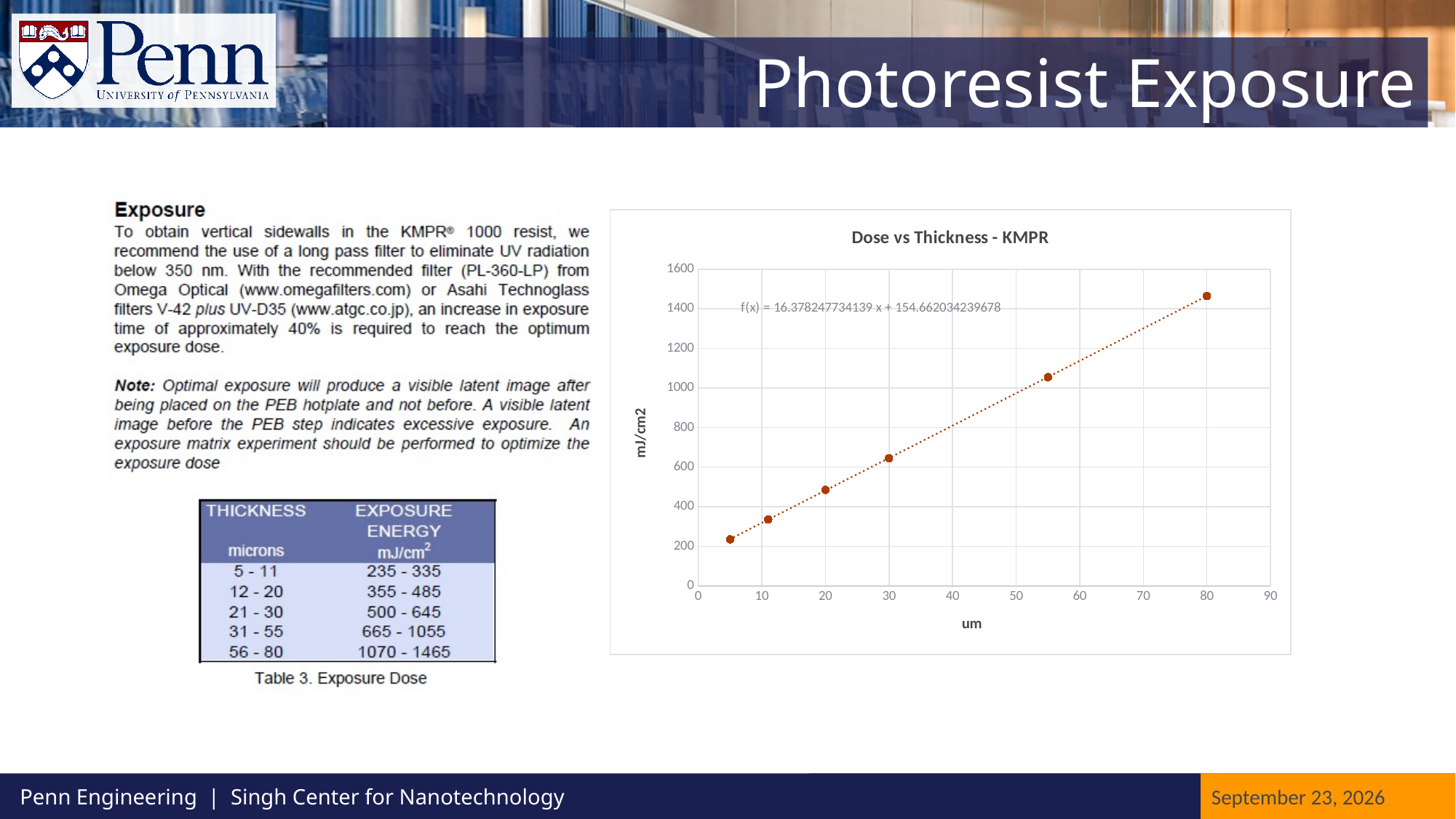
Do the plotted values rise or fall as thickness (um) increases? rise What kind of chart is shown on the slide? scatter chart What is the title of the chart? Dose vs Thickness - KMPR Is the value for the point at 30 um greater or less than 600 mJ/cm2? greater At which thickness (um) is the plotted dose lowest? 5 How many data points are plotted in the chart? 6 Is the value for the point at 11 um greater or less than 400 mJ/cm2? less Is the value for the point at 80 um greater or less than 1400 mJ/cm2? greater Which has the larger dose value, the point at 55 um or the point at 30 um? 55 um At which thickness (um) is the plotted dose highest? 80 What is the label on the y axis of the chart? mJ/cm2